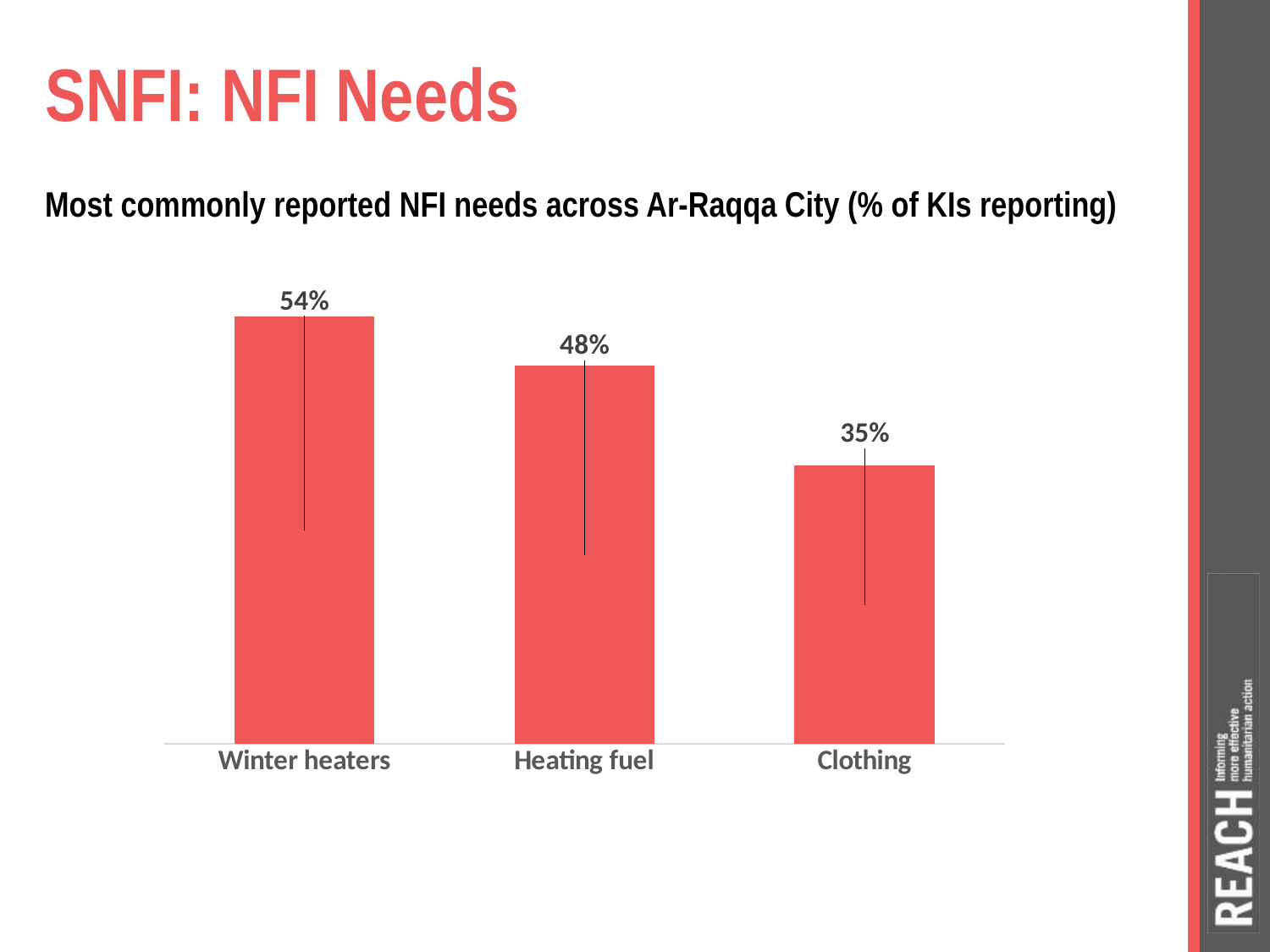
What is the title of the chart? Most commonly reported NFI needs across Ar-Raqqa City (% of KIs reporting) What is the difference in percentage points between winter heaters and clothing? 19 percentage points Do the values rise or fall moving from left to right across the categories? Fall What is the difference in percentage points between winter heaters and heating fuel? 6 percentage points Which NFI need was reported by the highest percentage of KIs? Winter heaters Which was reported by more KIs: heating fuel or clothing? Heating fuel What percentage of KIs reported heating fuel as an NFI need? 48% Which NFI need was reported by the lowest percentage of KIs? Clothing What percentage of KIs reported winter heaters as an NFI need? 54% What type of chart is used to show the NFI needs? Bar chart What percentage of KIs reported clothing as an NFI need? 35% How many NFI need categories are shown in the chart? 3